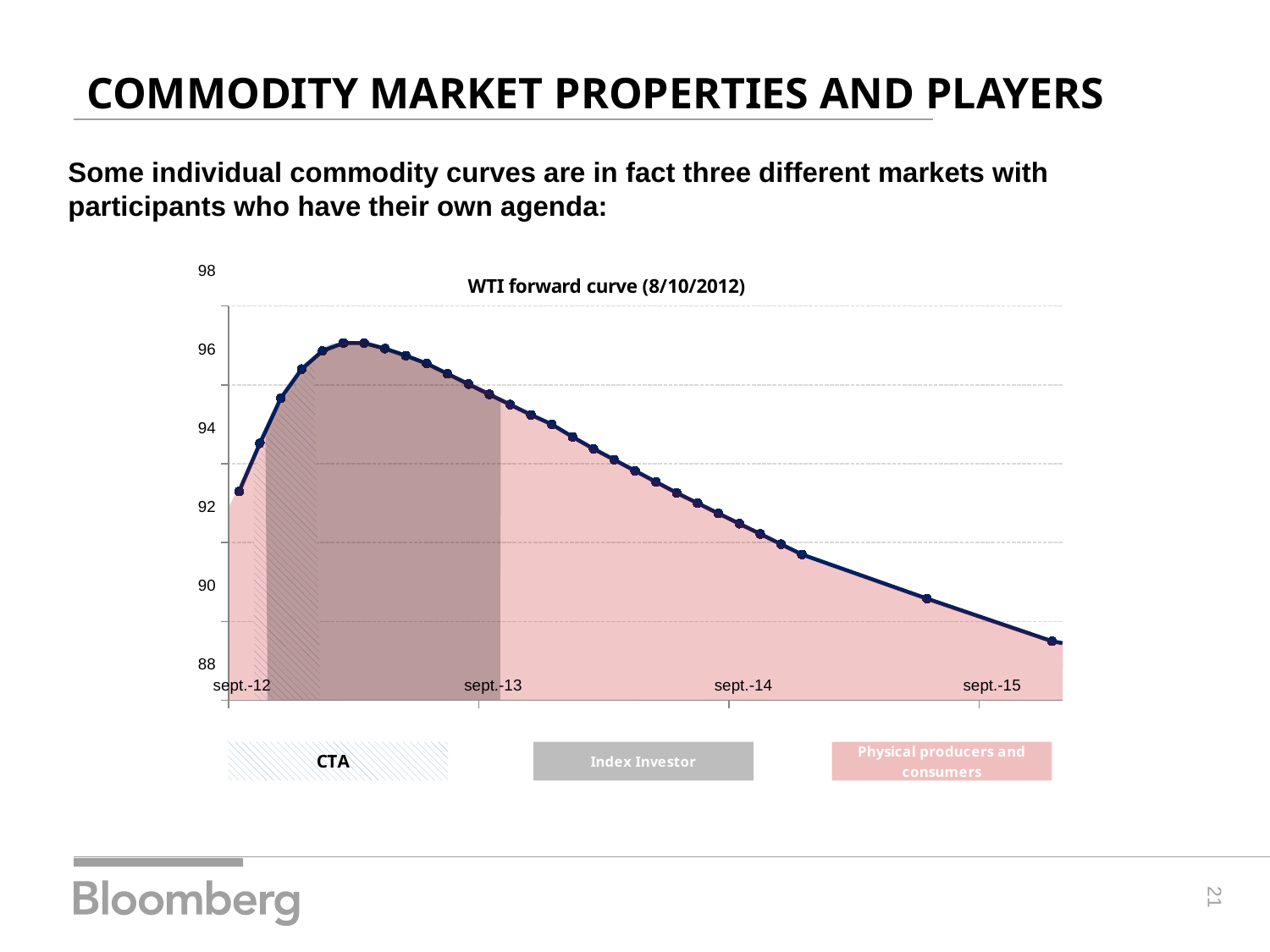
Is the value of the WTI forward curve at sept.-13 greater or less than 94? greater Is the value of the WTI forward curve at sept.-14 greater or less than 92? less Of the labelled dates on the x axis, which has the highest curve value? sept.-13 Which three market participant groups are labelled below the chart? CTA, Index Investor, Physical producers and consumers What kind of chart is shown on the slide? line chart Which is larger, the curve value at sept.-14 or at sept.-15? sept.-14 Which is larger, the curve value at sept.-12 or at sept.-13? sept.-13 Of the labelled dates on the x axis, which has the lowest curve value? sept.-15 What is the title of the chart? WTI forward curve (8/10/2012) Is the value of the WTI forward curve at sept.-15 greater or less than 90? less How does the WTI forward curve move from sept.-13 to sept.-15? it falls How many dates are labelled on the x axis? 4